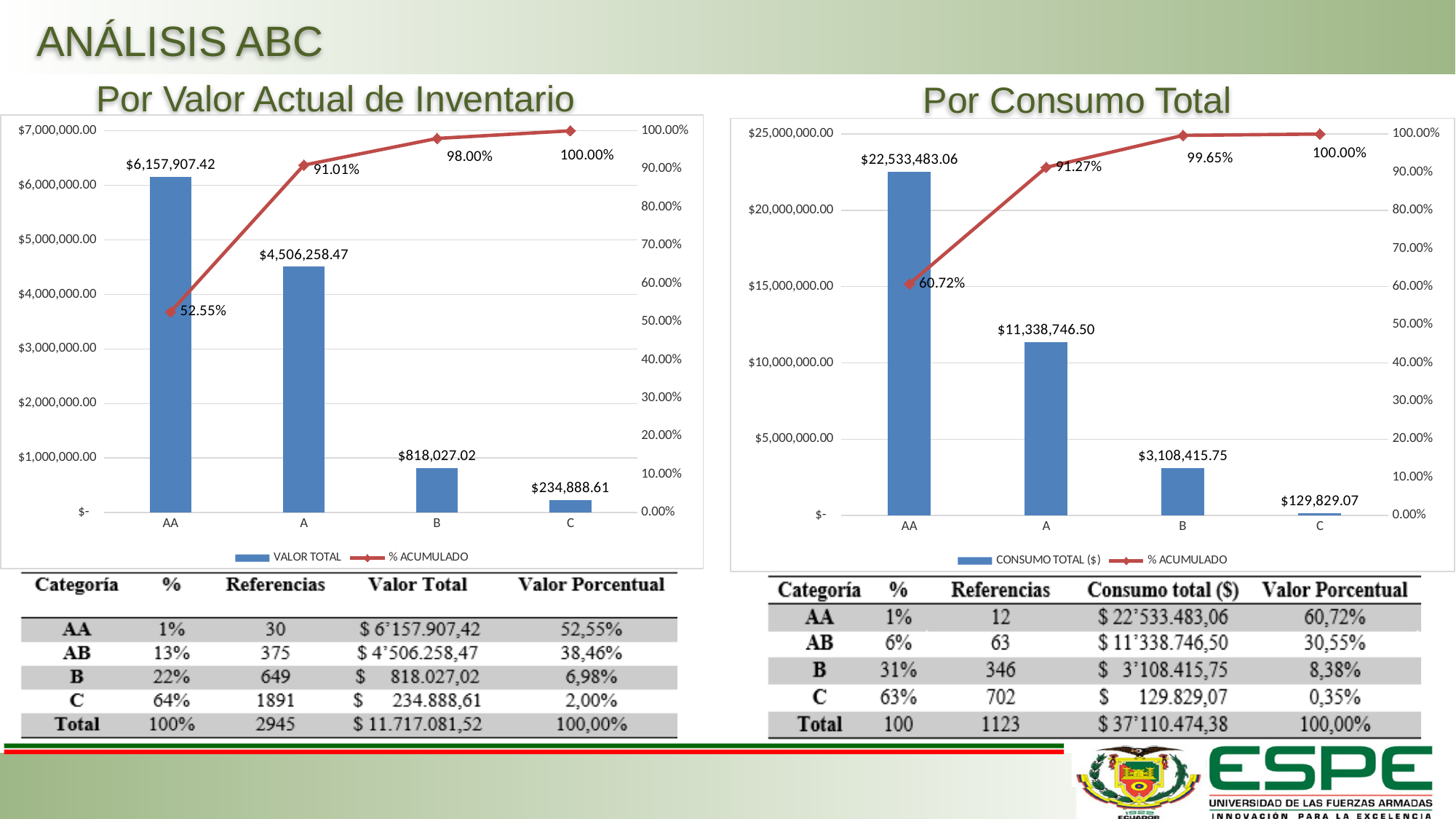
How many series does the legend of the 'Por Valor Actual de Inventario' chart list? 2 In the 'Por Consumo Total' chart, what is the CONSUMO TOTAL ($) for category B? $3,108,415.75 In the 'Por Valor Actual de Inventario' chart, what is the VALOR TOTAL for category AA? $6,157,907.42 How many categories are shown on the x axis of the 'Por Consumo Total' chart? 4 In the 'Por Consumo Total' chart, what is the % ACUMULADO value at category AA? 60.72% In the 'Por Consumo Total' chart, which category has the highest CONSUMO TOTAL ($)? AA In the 'Por Valor Actual de Inventario' chart, which category has the lowest VALOR TOTAL? C In the 'Por Valor Actual de Inventario' chart, is the VALOR TOTAL for A greater or less than $4,000,000.00? greater In the 'Por Consumo Total' chart, what is the difference between the CONSUMO TOTAL ($) of AA and A? $11,194,736.56 In the 'Por Valor Actual de Inventario' chart, what is the % ACUMULADO value at category A? 91.01% In the 'Por Valor Actual de Inventario' chart, which is larger, the VALOR TOTAL for B or for C? B In the 'Por Consumo Total' chart, does the % ACUMULADO line rise or fall from AA to C? rise